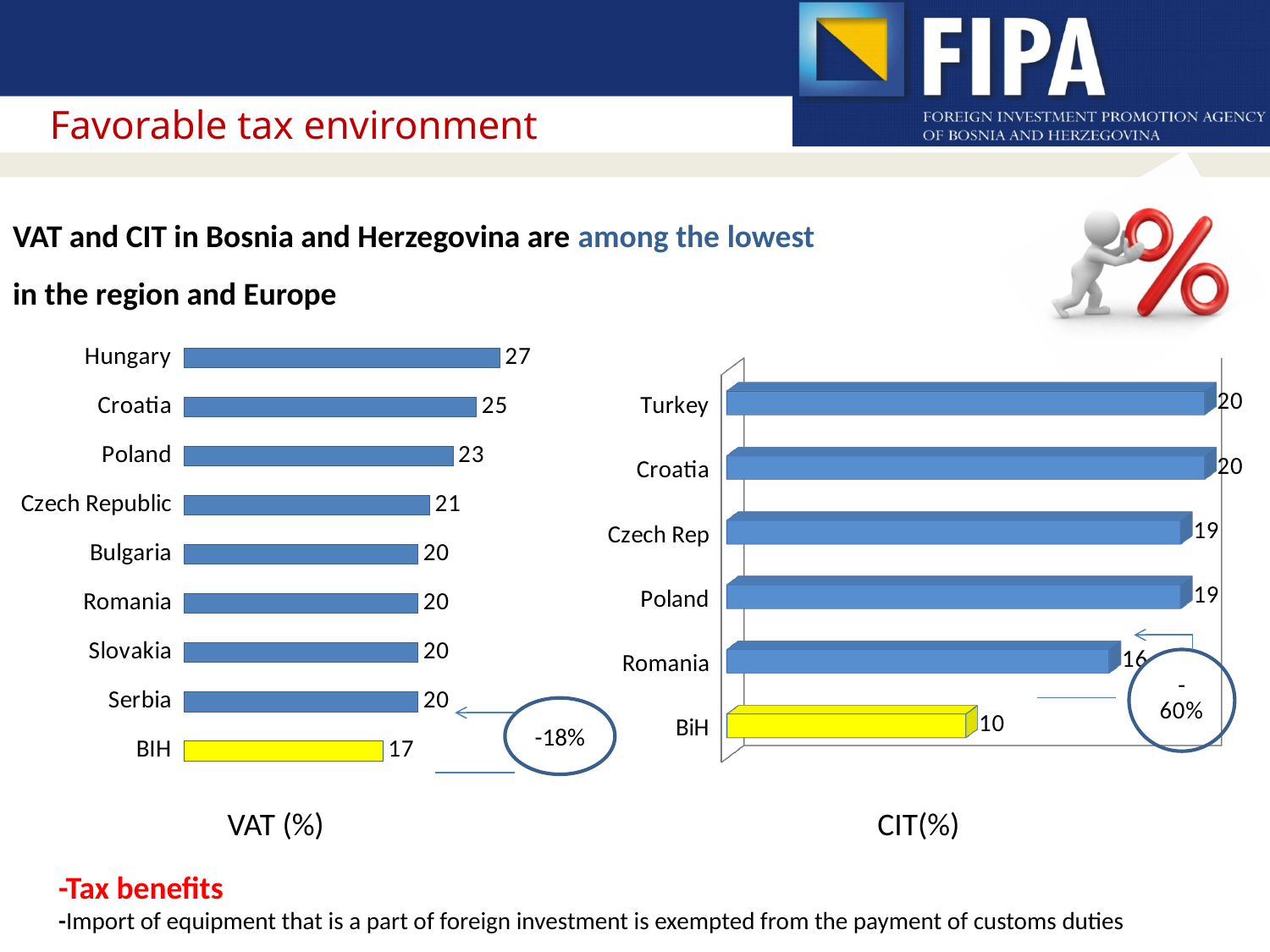
In the CIT(%) chart, which country has the lowest value? BiH In the VAT (%) chart, which country has the highest value? Hungary In the VAT (%) chart, which is larger, Croatia or Poland? Croatia In the CIT(%) chart, what is the value for BiH? 10 How many countries are shown in the CIT(%) chart? 6 In the CIT(%) chart, what is the value for Romania? 16 In the VAT (%) chart, which country has the lowest value? BIH In the VAT (%) chart, what is the difference between Hungary and BIH? 10 In the VAT (%) chart, what is the value for Hungary? 27 In the VAT (%) chart, what is the value for BIH? 17 How many countries are shown in the VAT (%) chart? 9 In the CIT(%) chart, what is the difference between Romania and BiH? 6